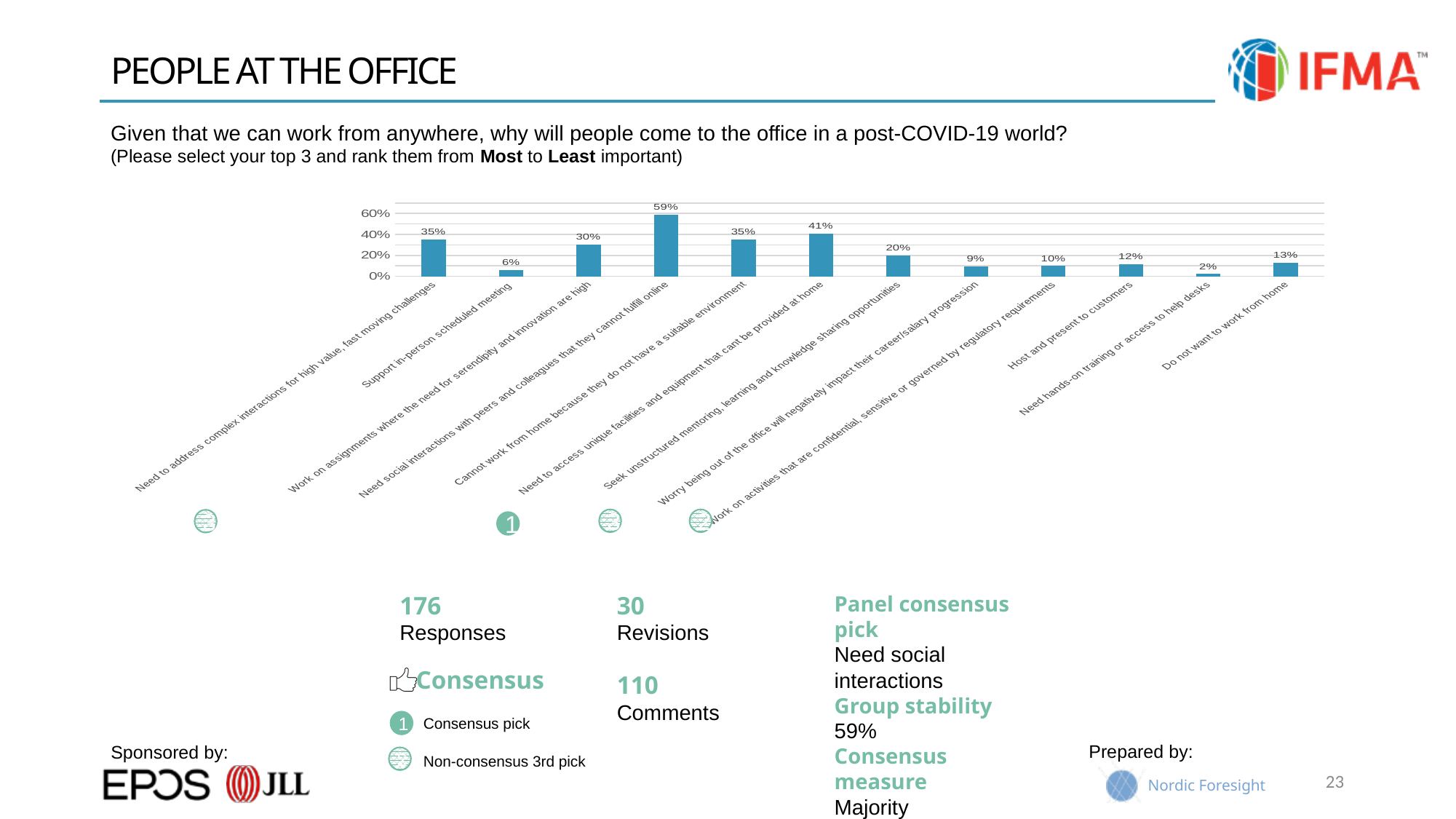
Which category has the highest percentage? Need social interactions with peers and colleagues that they cannot fulfill online What percentage is shown for "Do not want to work from home"? 13% How many categories are plotted in the chart? 12 What is the difference between the percentage for "Need to access unique facilities and equipment that cant be provided at home" and "Seek unstructured mentoring, learning and knowledge sharing opportunities"? 21% Is the value for "Worry being out of the office will negatively impact their career/salary progression" greater or less than 20%? less Which is larger: the percentage for "Work on assignments where the need for serendipity and innovation are high" or for "Need to access unique facilities and equipment that cant be provided at home"? Need to access unique facilities and equipment that cant be provided at home What percentage is shown for "Support in-person scheduled meeting"? 6% What percentage is shown for "Host and present to customers"? 12% What kind of chart is shown on the slide? Bar chart What percentage is shown for "Need social interactions with peers and colleagues that they cannot fulfill online"? 59% Which category has the lowest percentage? Need hands-on training or access to help desks What is the highest value shown on the chart's vertical axis? 60%